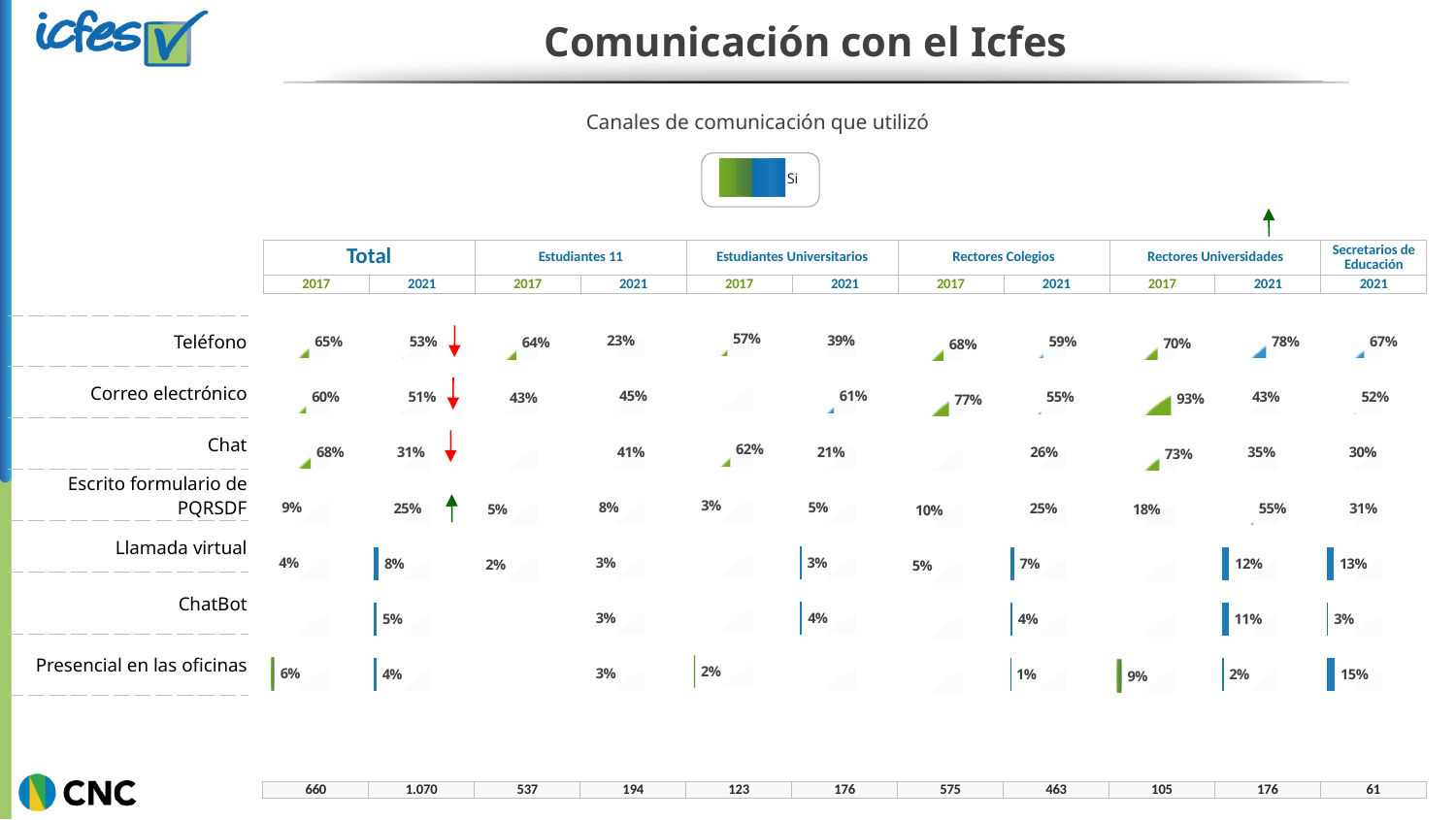
What is the Rectores Universidades 2017 value for Correo electrónico? 93% What is the Total 2021 value for Teléfono? 53% What is the base size shown for Total 2021 at the bottom of the chart? 1.070 What is the difference between the Total 2021 and Total 2017 values for Escrito formulario de PQRSDF? 16 percentage points What is the Estudiantes 11 2021 value for Chat? 41% What is the Secretarios de Educación 2021 value for Presencial en las oficinas? 15% What is the difference between the Total 2017 and Total 2021 values for Chat? 37 percentage points Which is larger for Teléfono: the Rectores Universidades 2017 value or the Rectores Universidades 2021 value? Rectores Universidades 2021 Which communication channel has the highest Total 2017 value? Chat What is the subtitle shown above the chart? Canales de comunicación que utilizó How many communication channels are listed as rows in the chart? 7 Which communication channel has the lowest Total 2021 value? Presencial en las oficinas